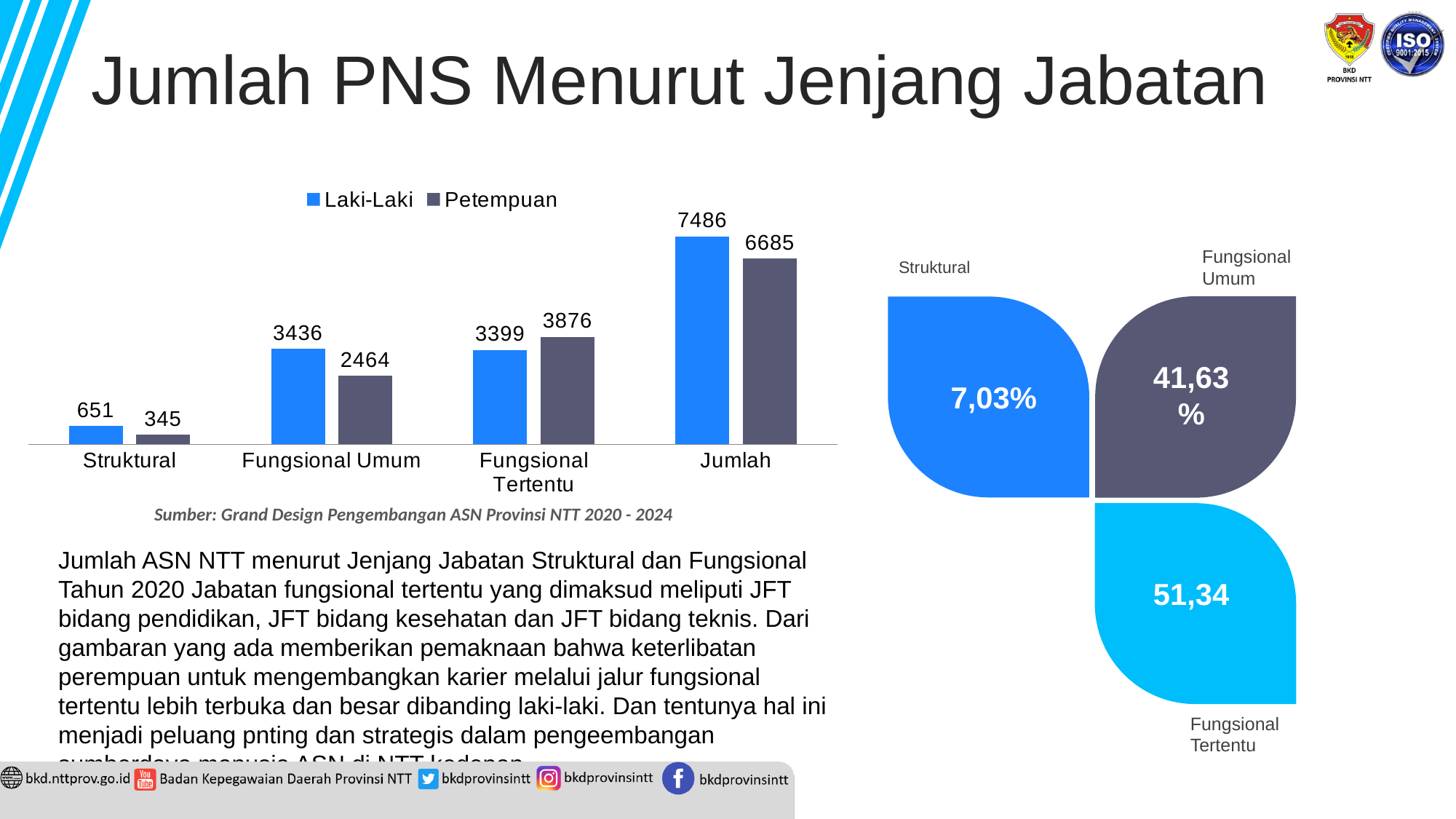
In the bar chart, which category has the lowest Petempuan value? Struktural What kind of chart is shown on the left of the slide? Bar chart In the bar chart, which category has the highest Laki-Laki value? Jumlah In the bar chart, what is the difference between the Laki-Laki and Petempuan values for Fungsional Umum? 972 In the bar chart, what is the Laki-Laki value for Struktural? 651 In the bar chart, what is the difference between the Laki-Laki and Petempuan values for Jumlah? 801 In the bar chart, what is the Petempuan value for Fungsional Umum? 2464 In the bar chart, for Fungsional Tertentu, which is larger: Laki-Laki or Petempuan? Petempuan How many categories are shown on the x axis of the bar chart? 4 In the bar chart, what is the Petempuan value for Fungsional Tertentu? 3876 In the bar chart, what is the Laki-Laki value for Jumlah? 7486 How many series does the legend of the bar chart list? 2